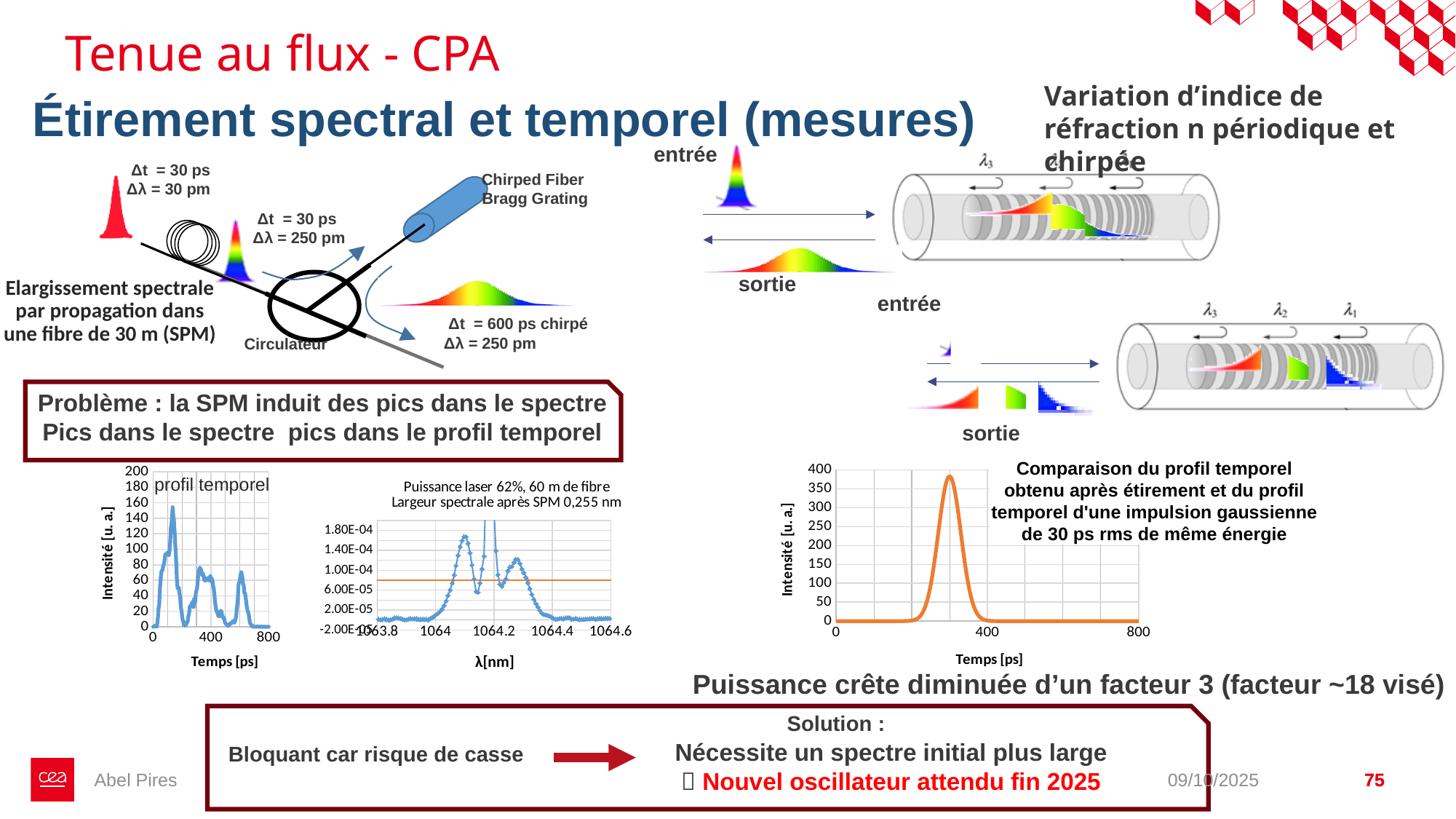
In the right-hand chart 'Comparaison du profil temporel...', is the value at 0 ps greater or less than 50? less How many charts are shown on the slide? 3 What is the y-axis label of the right-hand chart 'Comparaison du profil temporel...'? Intensité [u. a.] What is the x-axis label of the middle chart 'Puissance laser 62%, 60 m de fibre'? λ[nm] In the middle chart 'Puissance laser 62%, 60 m de fibre', is the highest peak greater or less than 1.40E-04? greater What kind of chart is the chart on the right titled 'Comparaison du profil temporel obtenu après étirement...'? line chart In the middle chart 'Puissance laser 62%, 60 m de fibre', is the value at 1063.8 nm greater or less than 2.00E-05? less In the 'profil temporel' chart on the left, do the values rise or fall between 600 ps and 800 ps? fall What kind of chart is the 'profil temporel' chart on the left of the slide? line chart In the right-hand chart 'Comparaison du profil temporel...', do the values rise or fall between 300 ps and 400 ps? fall